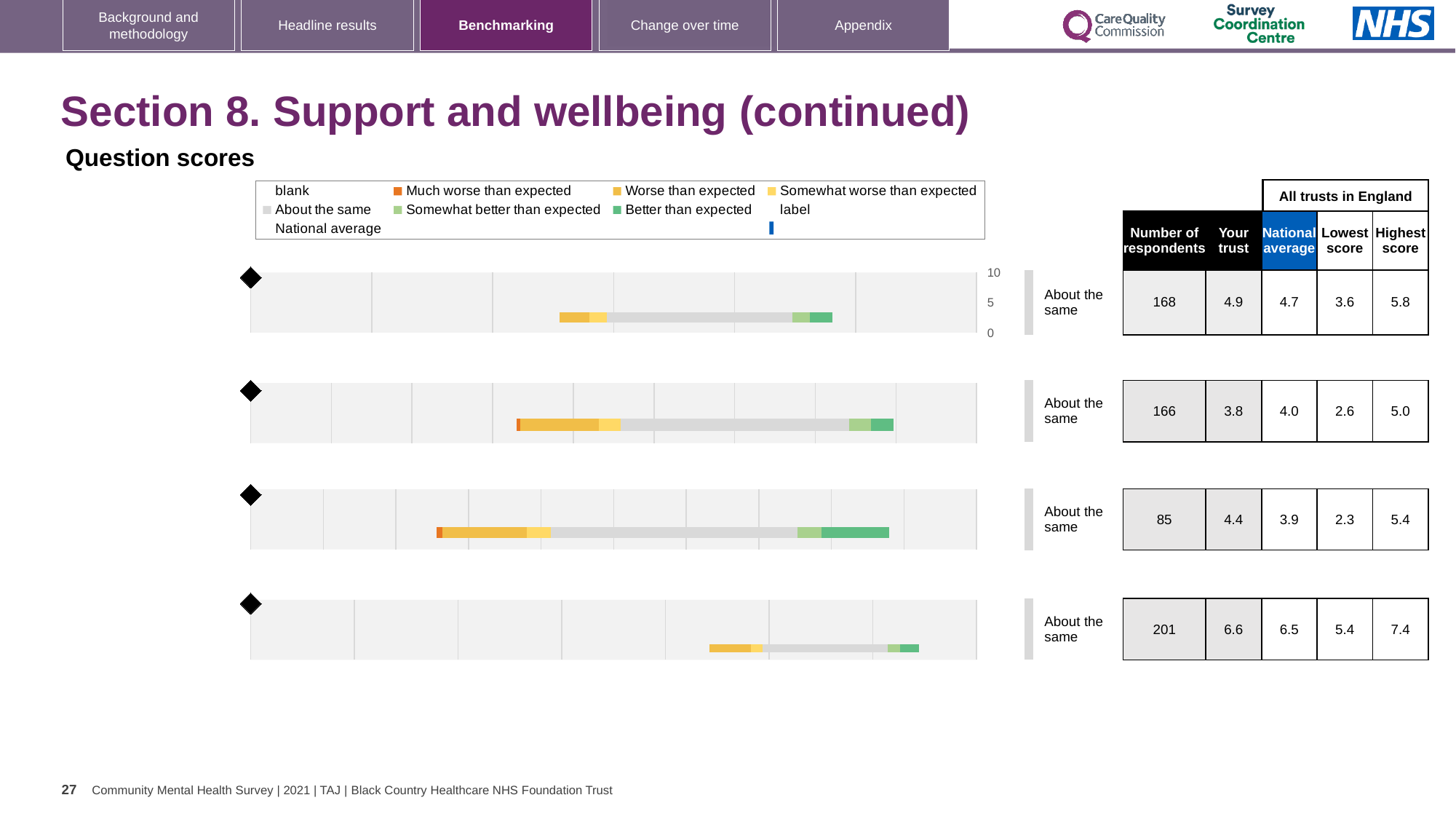
For the second chart from the top, what is the 'Your trust' score shown in the table? 3.8 For the first (top) chart, what is the number of respondents shown in the table? 168 For the fourth (bottom) chart, what is the difference between the highest score and the lowest score? 2.0 What kind of chart is used for the four question score charts on the slide? bar chart What benchmark category label is shown next to each of the four charts? About the same For the second chart from the top, what is the lowest score among all trusts in England? 2.6 For the first (top) chart, which is larger: the 'Your trust' score or the national average? Your trust How many question score charts are shown on the slide? 4 Which of the four charts has the highest 'Your trust' score? The fourth (bottom) chart For the second chart from the top, what is the difference between the national average and the 'Your trust' score? 0.2 For the third chart from the top, what is the national average shown in the table? 3.9 Which of the four charts has the lowest number of respondents? The third chart